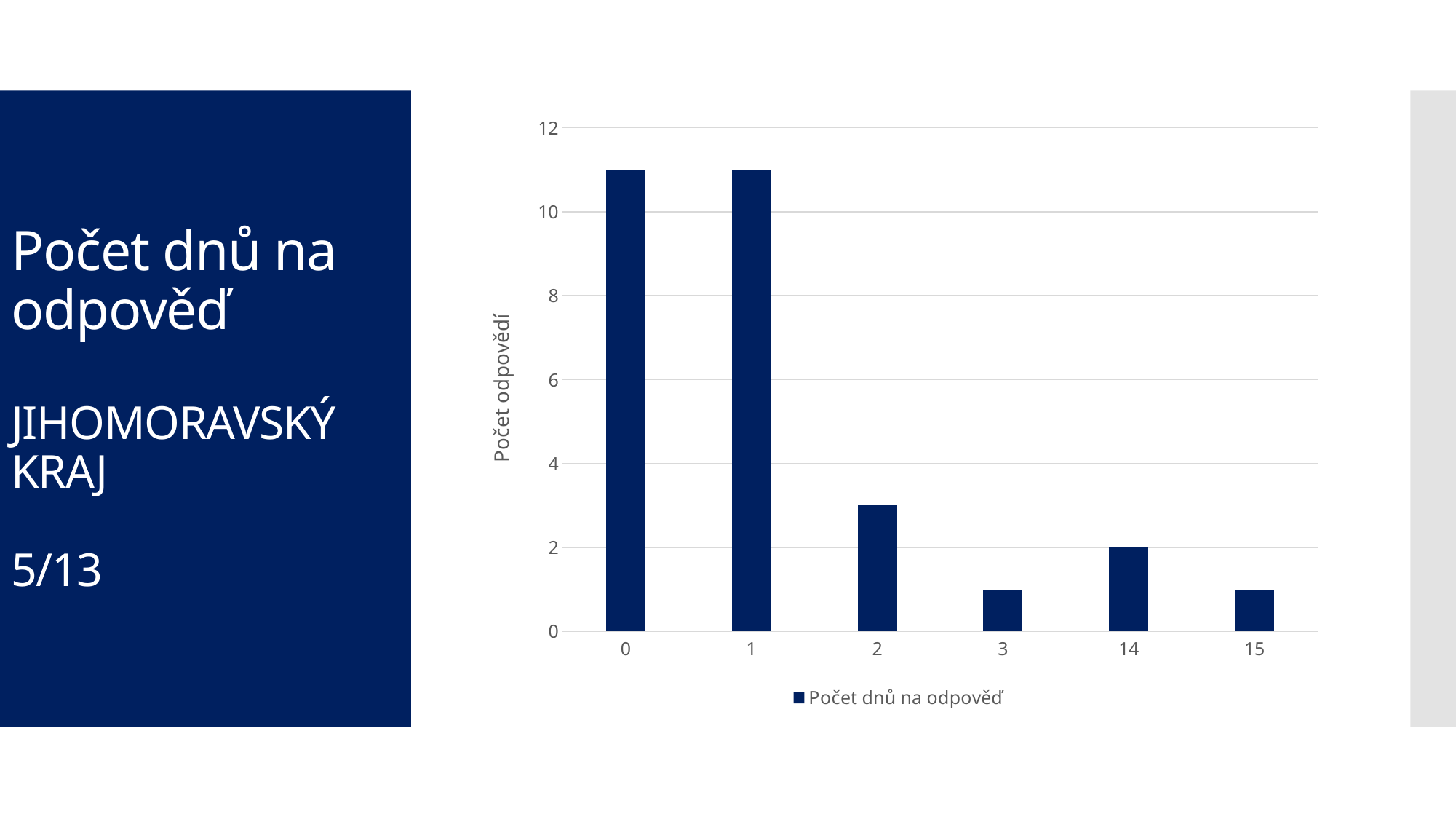
Is the value for category 1 greater or less than 12? less Is the value for category 15 greater or less than 2? less What is the label of the series shown in the chart legend? Počet dnů na odpověď Is the value for category 3 greater or less than 2? less Which has the larger value, category 0 or category 2? 0 What type of chart is shown on the slide? bar chart What is the value for category 14 in the chart? 2 Which has the larger value, category 14 or category 15? 14 How many categories are shown on the x axis of the chart? 6 How many series does the chart legend list? 1